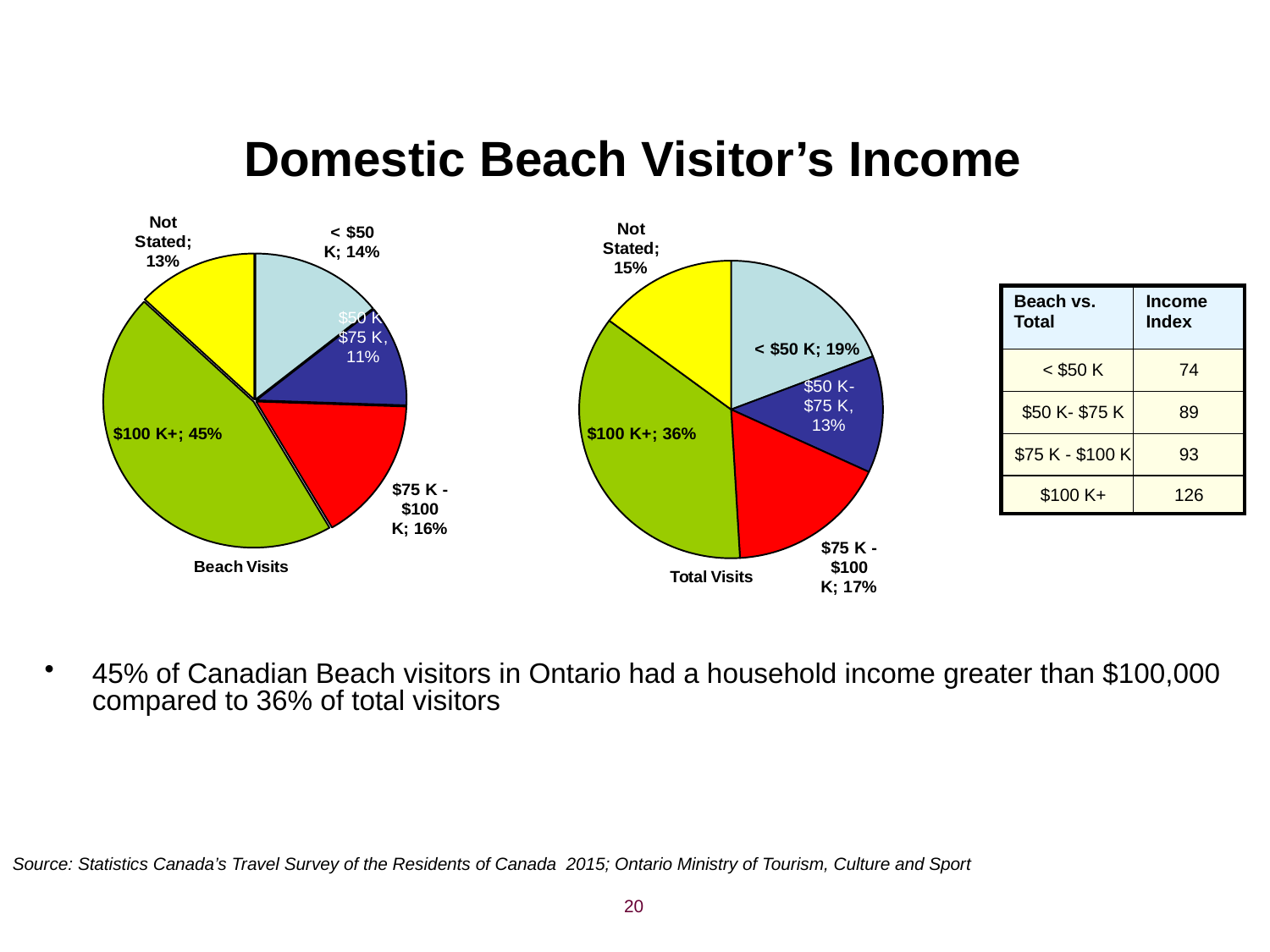
In the Beach Visits pie chart, what percentage is shown for $75 K - $100 K? 16% In the Beach Visits pie chart, which income category has the smallest slice? $50 K-$75 K In the Total Visits pie chart, what share of visitors had a household income of < $50 K? 19% What colour is the $100 K+ slice in the Total Visits pie chart? Green Is the < $50 K share larger in the Beach Visits chart or the Total Visits chart? Total Visits In the Beach Visits pie chart, what share of visitors had a household income of $100 K+? 45% In the Beach Visits pie chart, which income category has the largest slice? $100 K+ How many income categories are shown in the Beach Visits pie chart? 5 In the Total Visits pie chart, what percentage is shown for Not Stated? 15% In the Total Visits pie chart, which income category has the smallest slice? $50 K-$75 K What type of chart is used to show the Beach Visits data? Pie chart What is the difference between the $100 K+ share in the Beach Visits chart and the $100 K+ share in the Total Visits chart? 9 percentage points